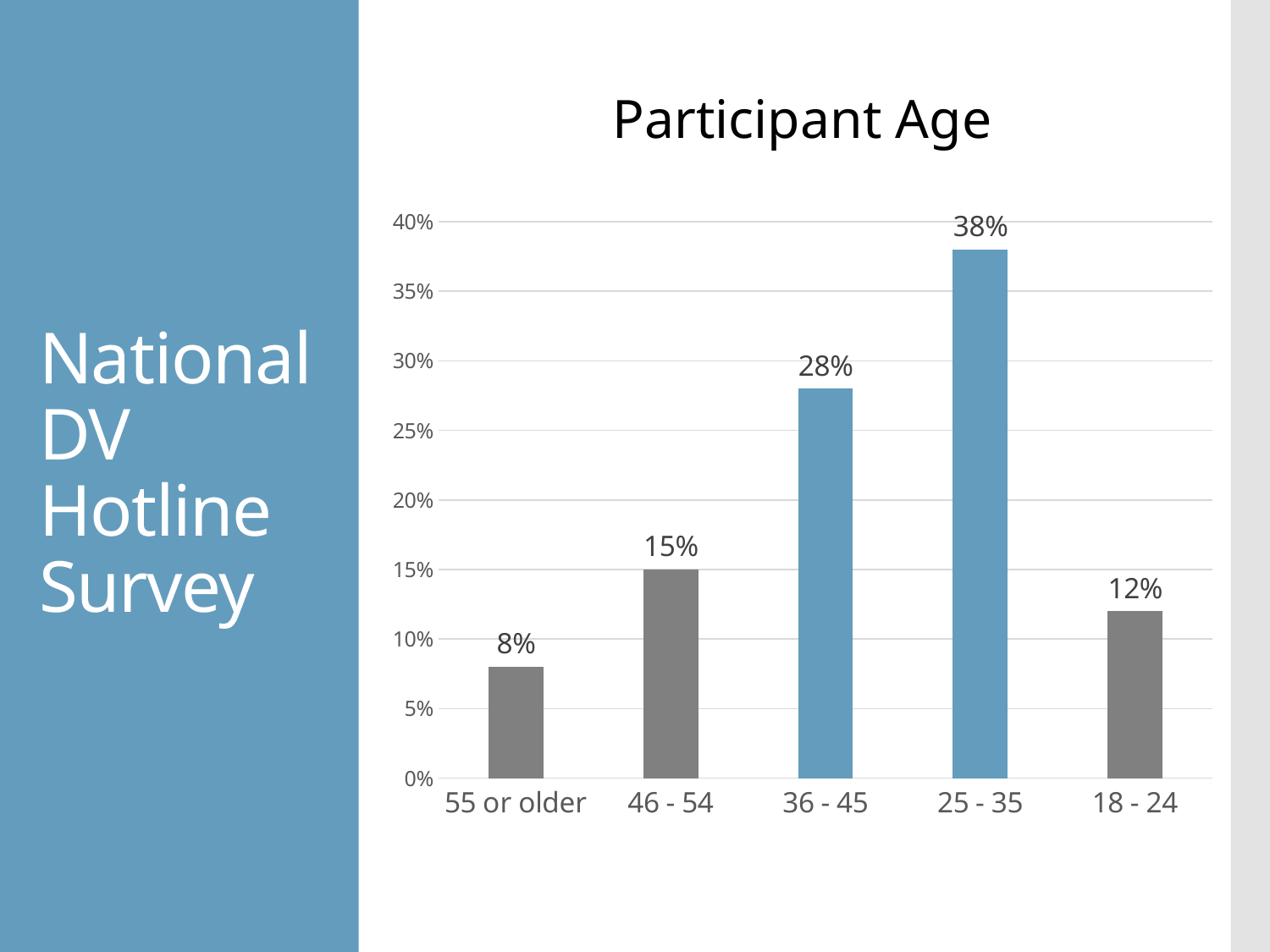
What is the title of the chart? Participant Age What is the value for the 18 - 24 age group? 12% What is the difference between the values for 46 - 54 and 18 - 24? 3% What is the value for the 25 - 35 age group? 38% What is the value for the 55 or older age group? 8% Is the value for 36 - 45 greater or less than 25%? greater What kind of chart is shown on the slide? bar chart How many age groups are shown on the chart? 5 Which is larger, the value for 46 - 54 or the value for 18 - 24? 46 - 54 What is the difference between the values for 25 - 35 and 36 - 45? 10% Which age group has the lowest value? 55 or older Which age group has the highest value? 25 - 35